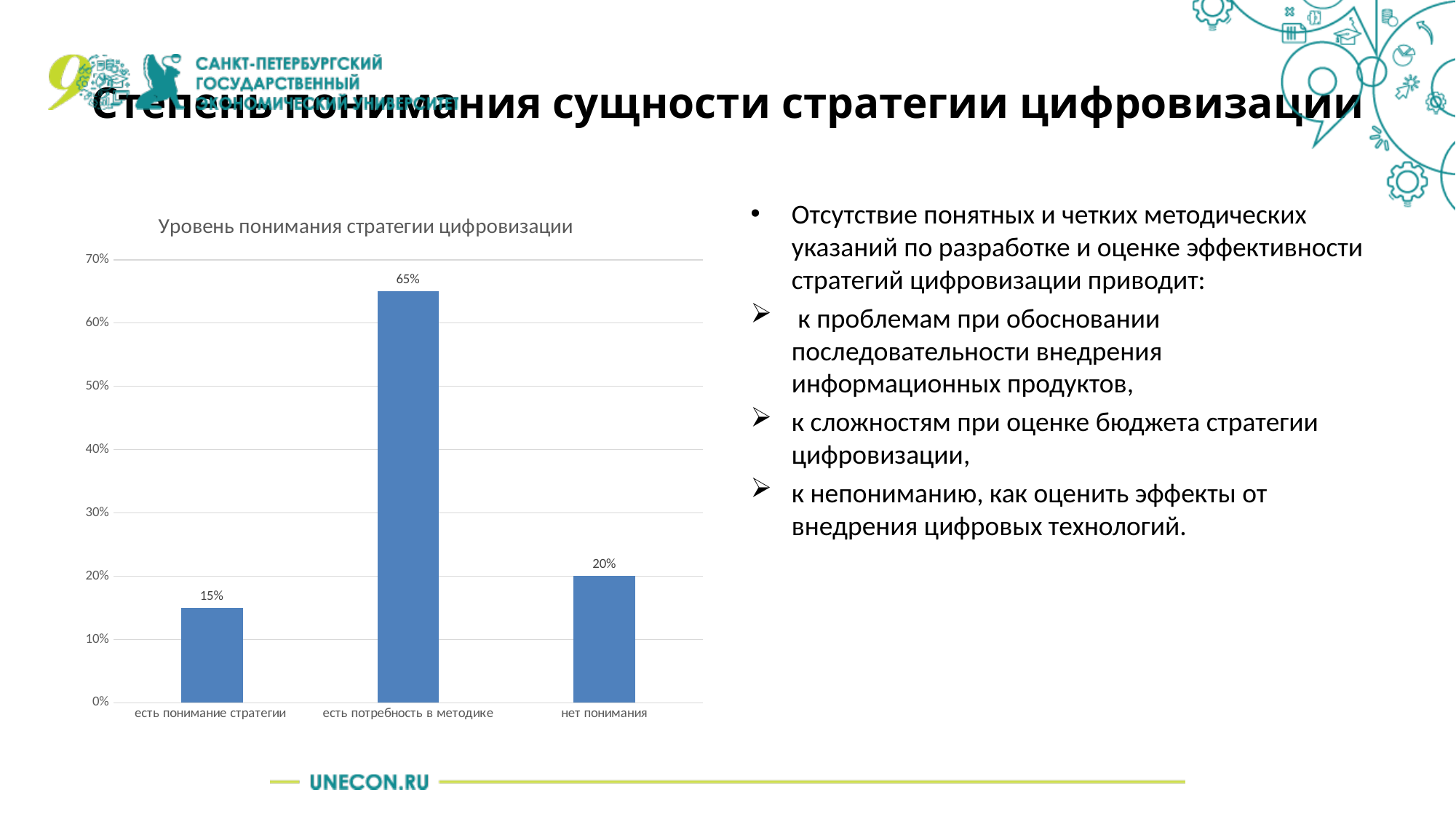
How many categories are shown in the chart? 3 Which category has the lowest value? есть понимание стратегии What is the title of the chart? Уровень понимания стратегии цифровизации What kind of chart is shown on the slide? bar chart What is the difference between the values for "есть потребность в методике" and "нет понимания"? 45% What is the value for "есть потребность в методике"? 65% Is the value for "есть потребность в методике" greater or less than 60%? greater What is the difference between the values for "нет понимания" and "есть понимание стратегии"? 5% What is the value for "есть понимание стратегии"? 15% Which category has the highest value? есть потребность в методике Which is larger, the value for "нет понимания" or the value for "есть понимание стратегии"? нет понимания What is the value for "нет понимания"? 20%